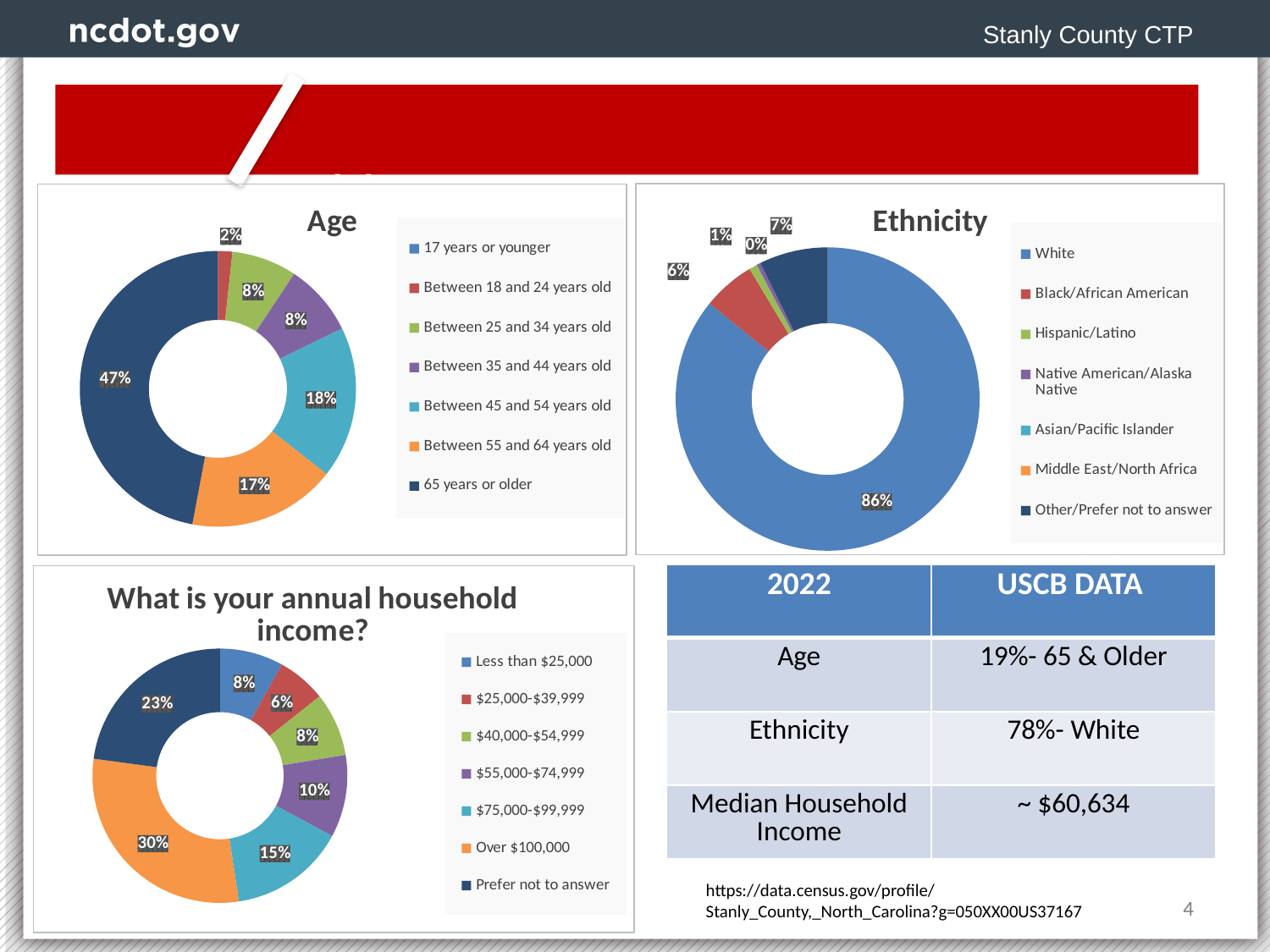
In the Ethnicity chart, what percentage of respondents are White? 86% In the household income chart, what is the difference between the share earning over $100,000 and the share earning less than $25,000? 22% In the Age chart, what percentage of respondents are between 45 and 54 years old? 18% In the household income chart, what percentage of respondents preferred not to answer? 23% In the household income chart, which is larger: the share earning $75,000-$99,999 or the share earning $55,000-$74,999? $75,000-$99,999 In the Age chart, what percentage of respondents are 65 years or older? 47% In the Age chart, what is the difference between the shares for 45 to 54 years old and 55 to 64 years old? 1% In the household income chart, what percentage of respondents earn over $100,000? 30% In the Ethnicity chart, what percentage of respondents are Black/African American? 6% What type of chart is used for the Age data? Donut (pie) chart In the Age chart, which age group has the largest share? 65 years or older In the Ethnicity chart, how many categories does the legend list? 7